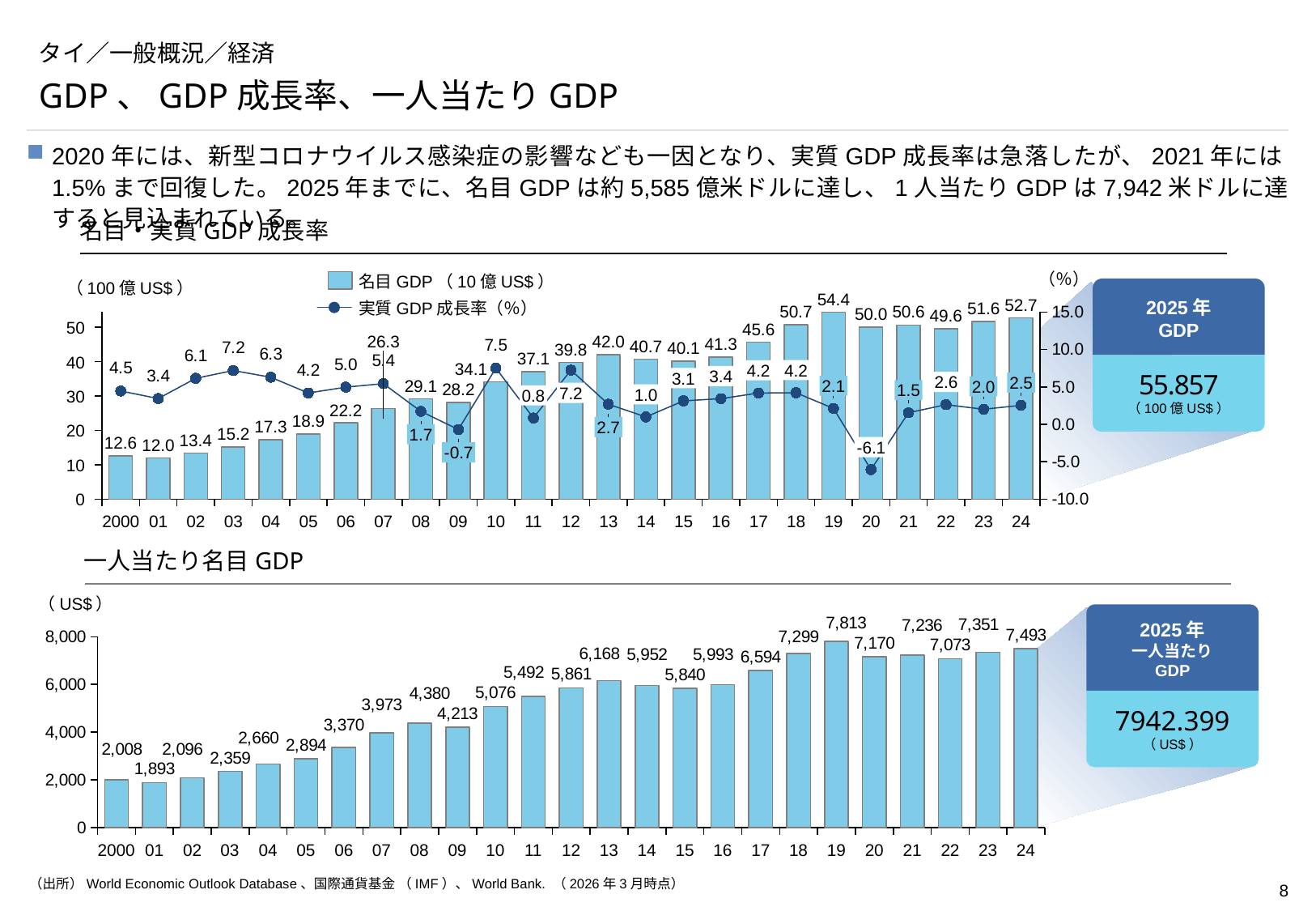
What kind of chart is the 一人当たり名目GDP chart? Bar chart In the 名目・実質GDP成長率 chart, which year has the highest nominal GDP? 2019 In the 名目・実質GDP成長率 chart, how many series does the legend list? 2 In the 一人当たり名目GDP chart, which year has the lowest value? 2001 In the 名目・実質GDP成長率 chart, what is the difference between the nominal GDP of 2019 and 2020? 4.4 In the 一人当たり名目GDP chart, what is the value for 2024? 7,493 In the 一人当たり名目GDP chart, which year has the highest value? 2019 In the 一人当たり名目GDP chart, what is the difference between the values for 2024 and 2023? 142 In the 一人当たり名目GDP chart, which is larger, the value for 2013 or the value for 2014? 2013 In the 名目・実質GDP成長率 chart, what is the nominal GDP value for 2019? 54.4 In the 名目・実質GDP成長率 chart, what is the real GDP growth rate for 2020? -6.1 In the 名目・実質GDP成長率 chart, which year has the lowest real GDP growth rate? 2020